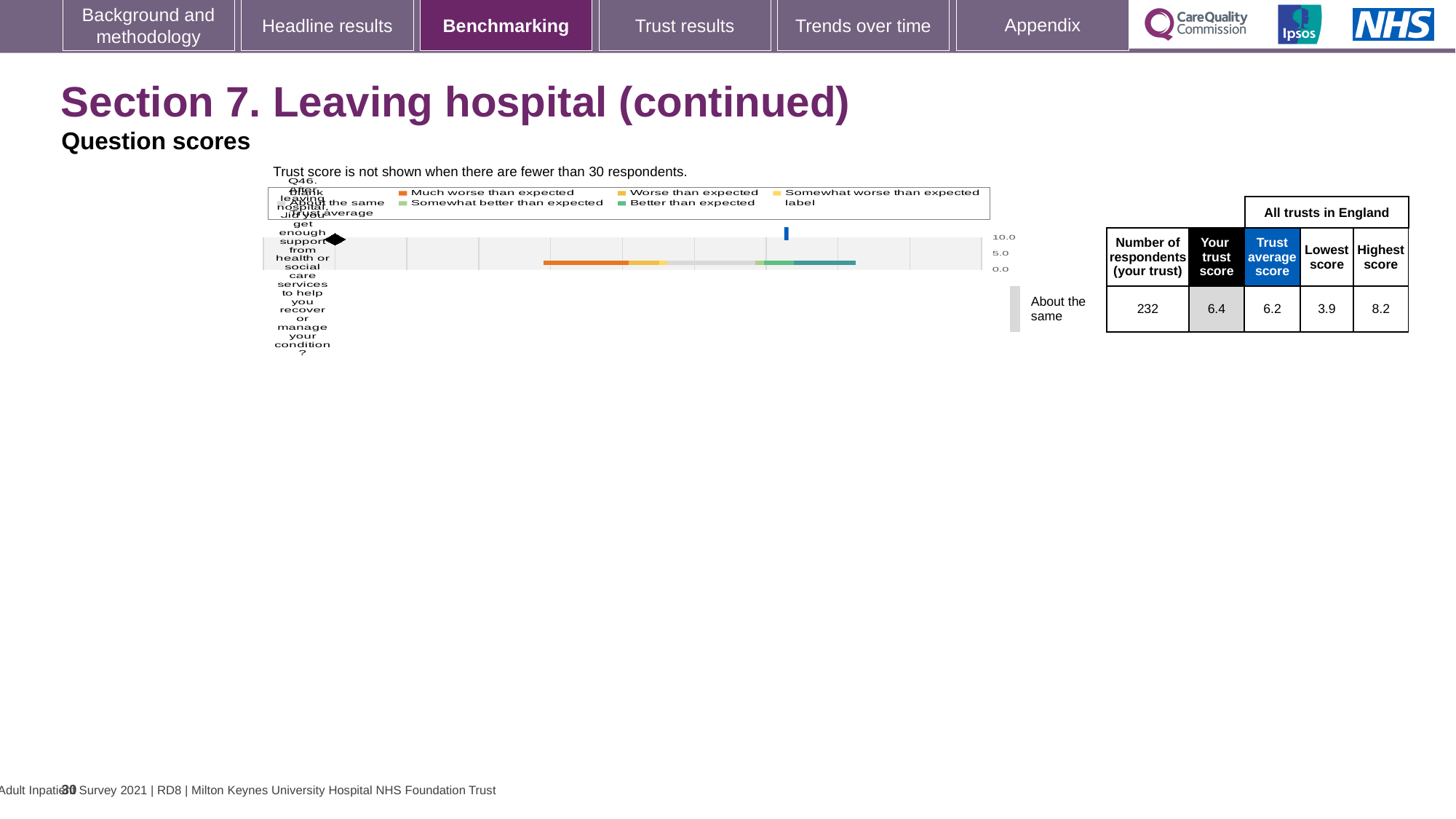
In the table beside the chart, what is the highest score among all trusts in England? 8.2 In the table beside the chart, what is the trust average score? 6.2 Which benchmark category is shown next to the chart for Q46? About the same Which is larger, your trust score or the trust average score? Your trust score In the table beside the chart, what is the lowest score among all trusts in England? 3.9 How many questions (categories) are plotted in the chart? 1 What kind of chart is shown on the slide? bar chart What is the difference between the highest score and the lowest score across all trusts in England? 4.3 In the table beside the chart, what is your trust score for Q46? 6.4 What is the difference between your trust score and the trust average score? 0.2 In the table beside the chart, what is the number of respondents for your trust? 232 What is the highest value shown on the chart's axis? 10.0